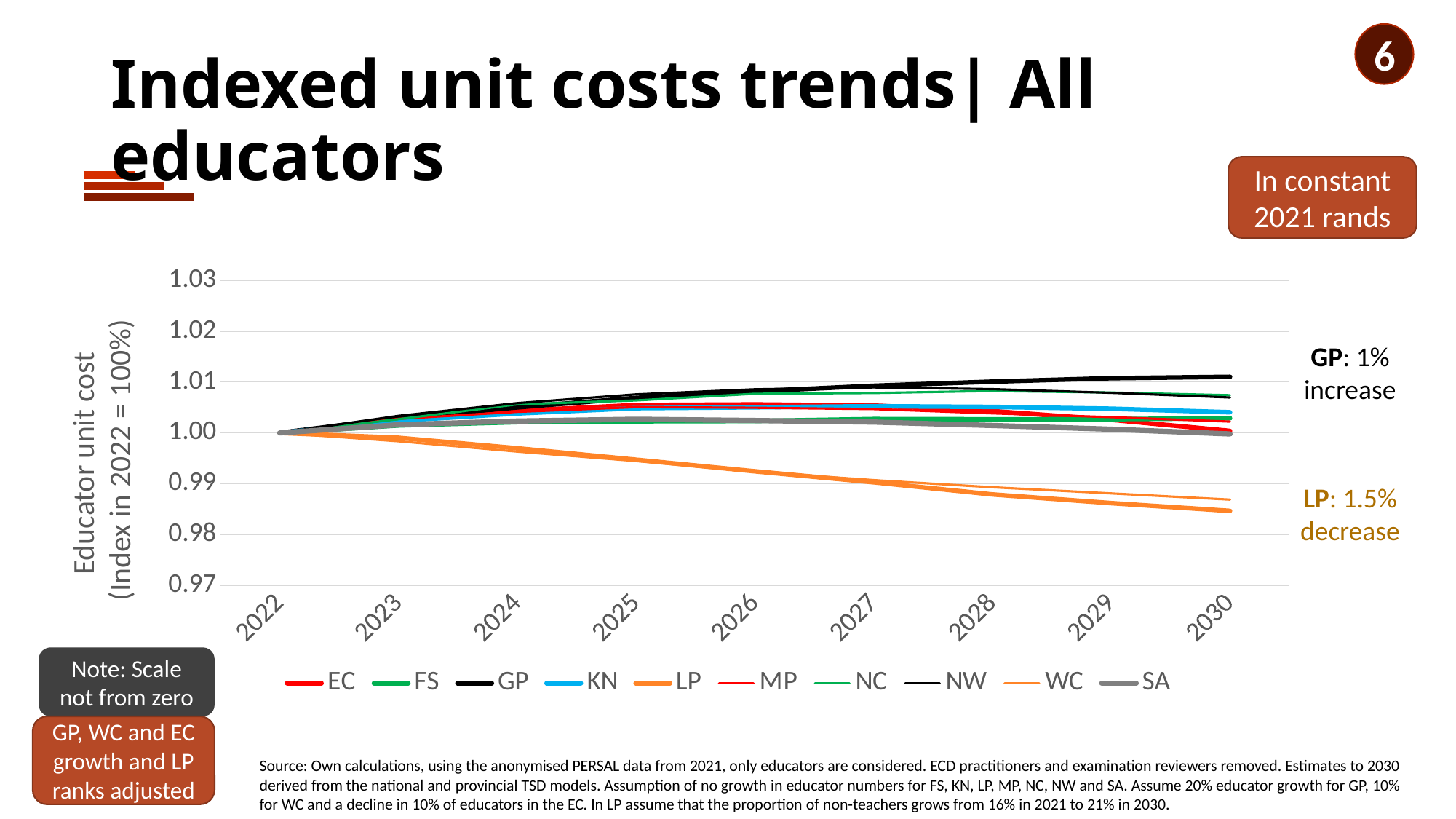
How many series does the legend list? 10 How many years are shown along the x axis? 9 Is the value for GP in 2030 greater or less than 1.00? greater What is the index value for GP in 2022? 1.00 What is the y-axis title of the chart? Educator unit cost (Index in 2022 = 100%) Which is larger in 2030, the value for GP or the value for LP? GP Which series has the highest educator unit cost index in 2030? GP Which series has the lowest educator unit cost index in 2030? LP According to the annotation on the chart, what change does GP show? 1% increase What type of chart is shown on the slide? line chart Does the LP line rise or fall from 2022 to 2030? fall Is the value for LP in 2030 greater or less than 0.99? less